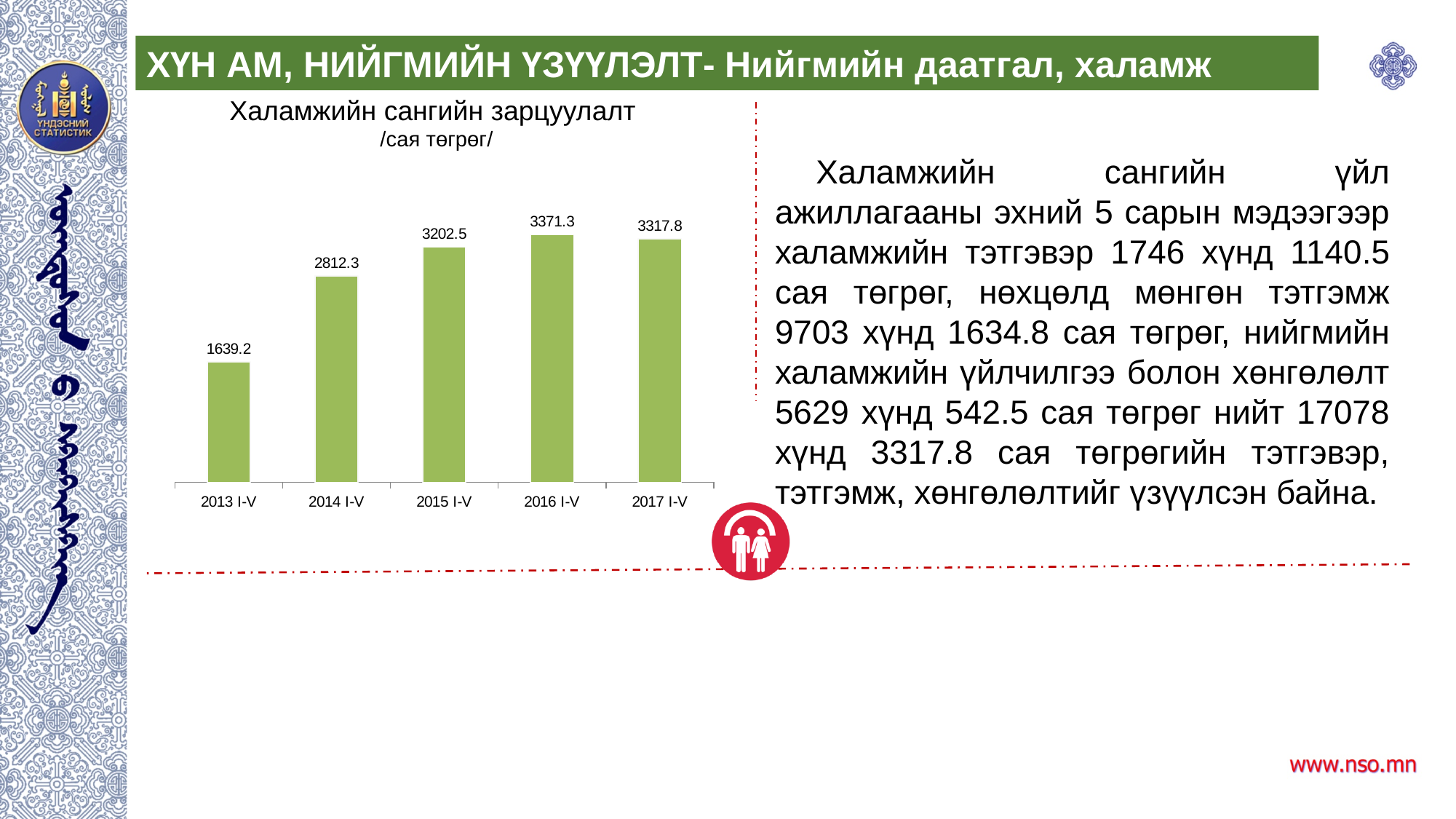
What is the difference between the values for 2016 I-V and 2017 I-V? 53.5 What unit is given under the chart title? сая төгрөг What kind of chart is shown? Bar chart Which is larger, the value for 2014 I-V or 2015 I-V? 2015 I-V What is the value for 2017 I-V? 3317.8 What is the value for 2015 I-V? 3202.5 What is the difference between the values for 2014 I-V and 2013 I-V? 1173.1 Which period has the lowest value? 2013 I-V Which period has the highest value? 2016 I-V What is the value for 2013 I-V? 1639.2 Do the values rise or fall from 2013 I-V to 2016 I-V? Rise How many periods are shown on the x axis? 5